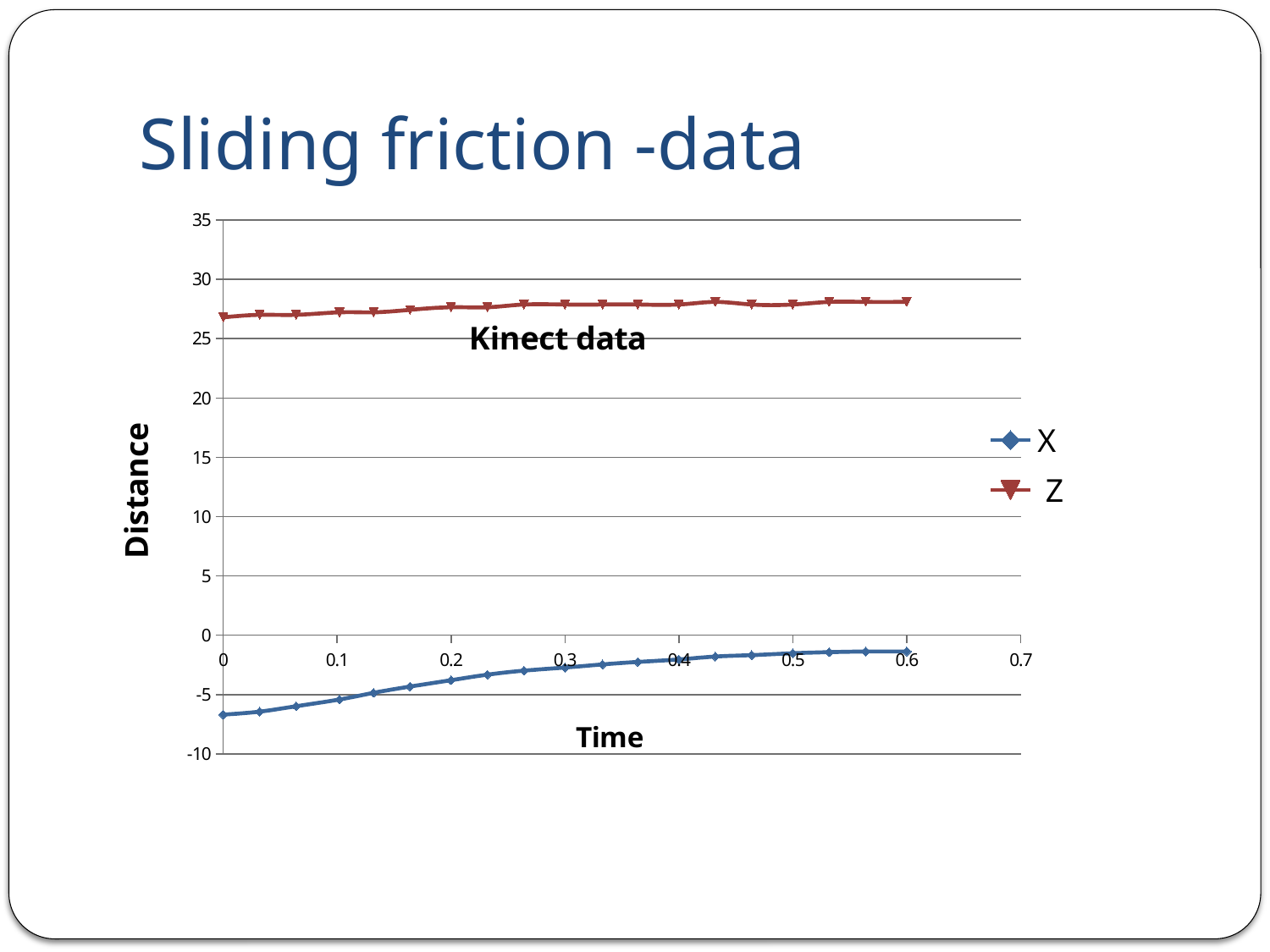
Do the values of series X rise or fall as Time increases? rise Is the value of series Z at Time 0.6 greater or less than 30? less Is the value of series Z at Time 0 greater or less than 25? greater Is the value of series X at Time 0 greater or less than -5? less What kind of chart is shown on the slide? line chart What are the names of the series listed in the legend? X and Z Which series has the higher values throughout the chart, X or Z? Z How many series does the legend list? 2 What is the label on the vertical axis? Distance